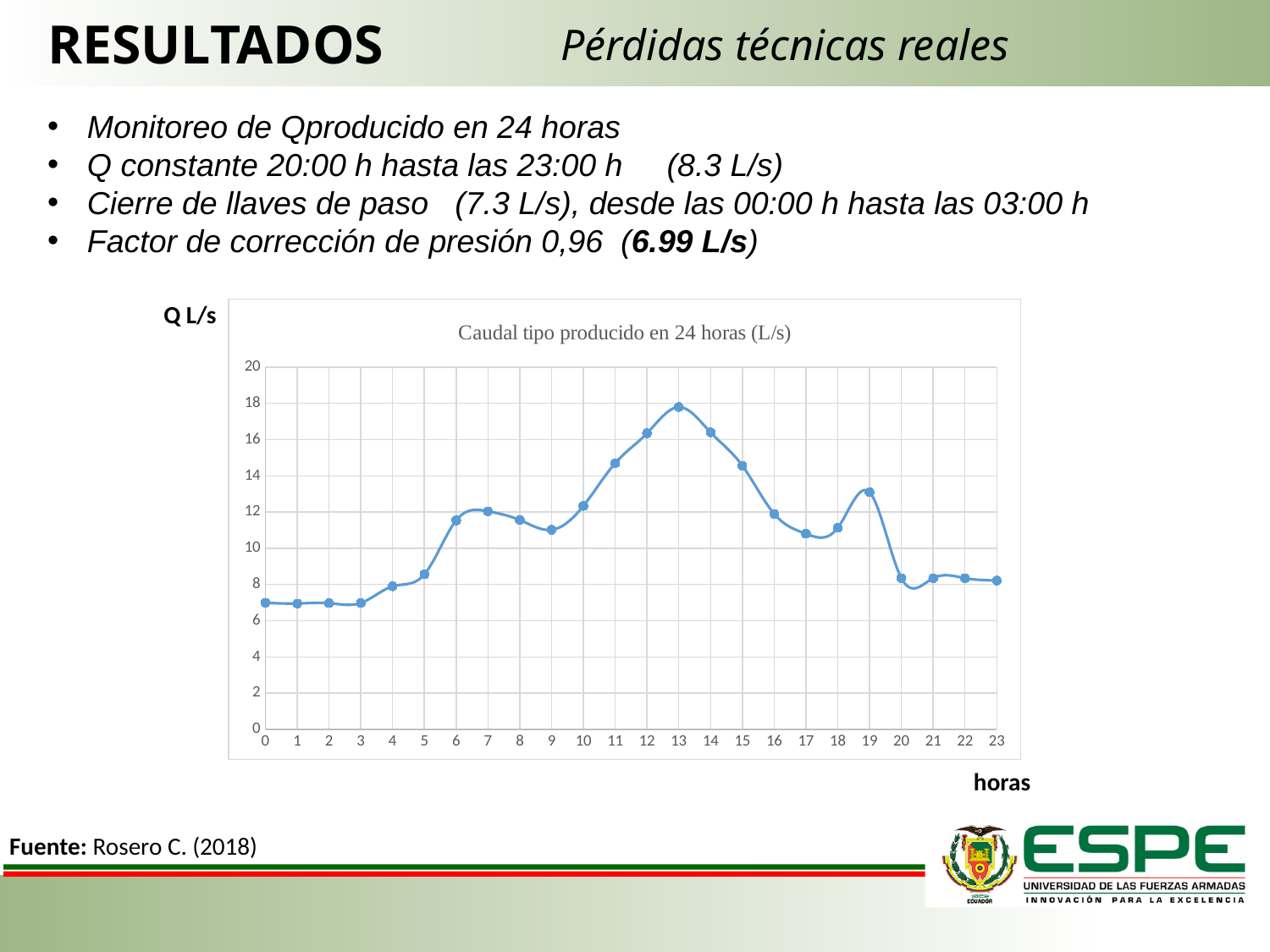
What kind of chart is shown on the slide? line chart Is the value at hour 19 greater or less than 12? greater How many data points are plotted on the chart? 24 Which hour has the larger value, hour 17 or hour 19? 19 Is the value at hour 0 greater or less than 8? less Is the value at hour 13 greater or less than 16? greater Do the values rise or fall from hour 13 to hour 17? fall What is the title of the chart? Caudal tipo producido en 24 horas (L/s) What label is shown on the horizontal axis of the chart? horas At which hour does the chart reach its highest value? 13